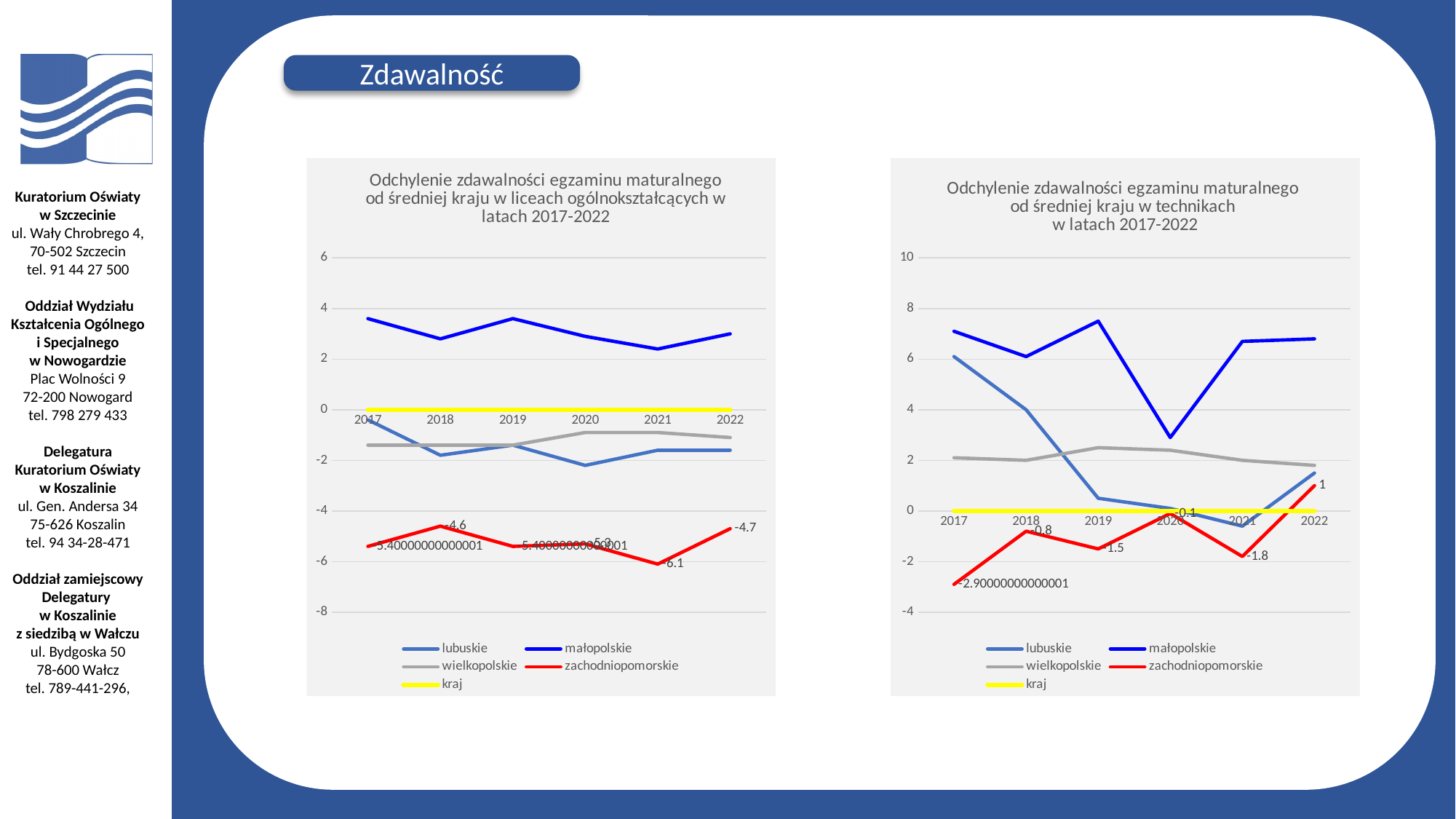
In the chart on the left (licea ogólnokształcące), what is the value for zachodniopomorskie in 2021? -6.1 How many series does the legend of the chart on the left (licea ogólnokształcące) list? 5 In the chart on the right (technika), which is larger in 2020: małopolskie or wielkopolskie? małopolskie In the chart on the right (technika), in which year is the zachodniopomorskie value highest? 2022 In the chart on the right (technika), what is the difference between the zachodniopomorskie values in 2022 and 2021? 2.8 In the chart on the right (technika), what is the value for zachodniopomorskie in 2018? -0.8 In the chart on the left (licea ogólnokształcące), in which year is the zachodniopomorskie value lowest? 2021 What type of chart is the chart on the right (technika)? line chart In the chart on the left (licea ogólnokształcące), is the value for małopolskie in 2019 greater or less than 2? greater In the chart on the right (technika), is the value for lubuskie in 2017 greater or less than 4? greater In the chart on the right (technika), what is the value for zachodniopomorskie in 2022? 1 In the chart on the left (licea ogólnokształcące), what is the value for zachodniopomorskie in 2018? -4.6